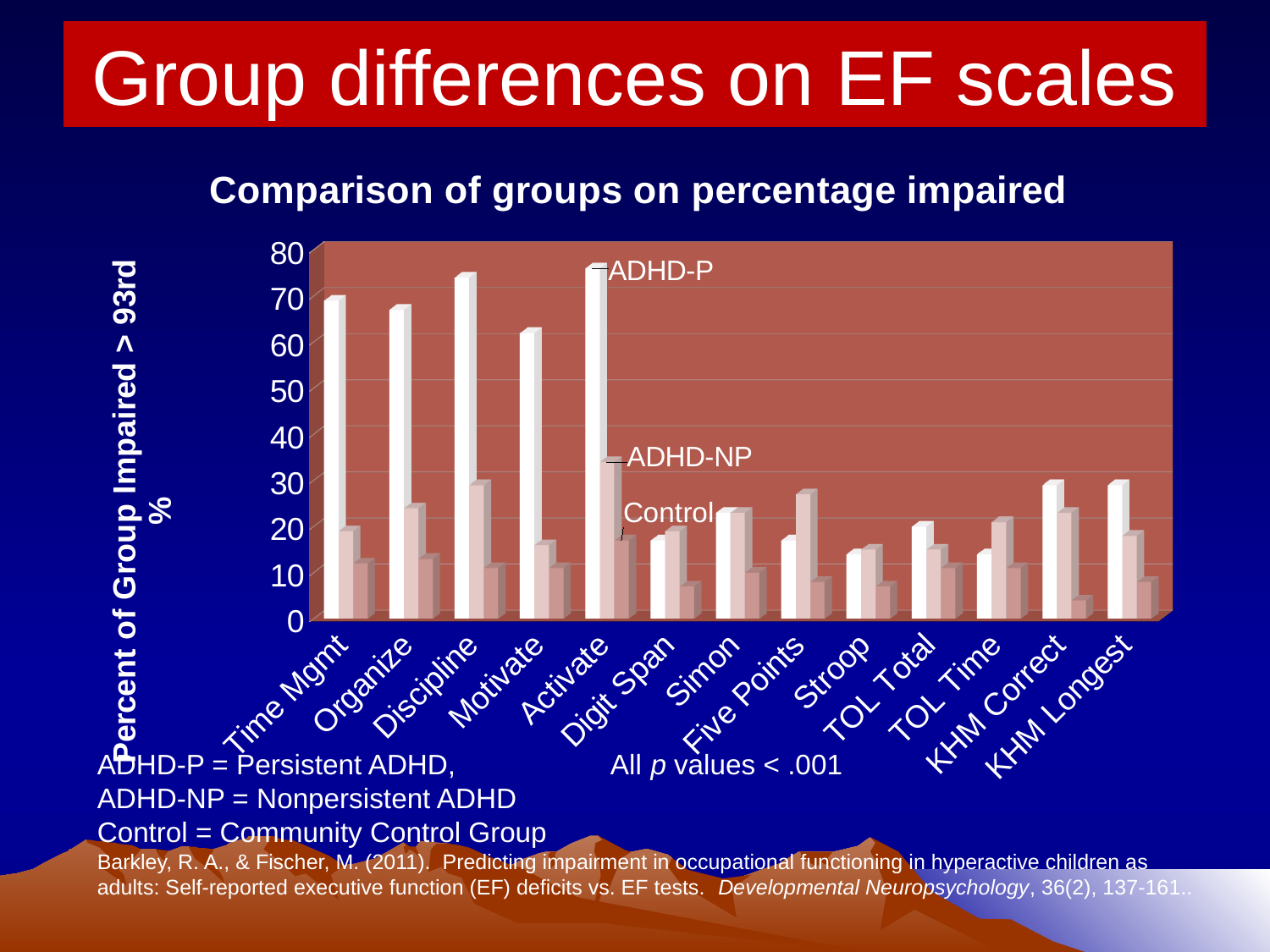
What is the title of the chart? Comparison of groups on percentage impaired How many categories are shown along the x axis of the chart? 13 Is the Control value for Time Mgmt greater or less than 20? less How many groups (series) are plotted in the chart? 3 For the Discipline category, which group has the larger value, ADHD-P or Control? ADHD-P For the ADHD-P group, which category has the larger value, Time Mgmt or Stroop? Time Mgmt What is the label of the vertical axis? Percent of Group Impaired > 93rd % Is the ADHD-P value for Motivate greater or less than 50? greater Is the ADHD-P value for Digit Span greater or less than 30? less What type of chart is shown on the slide? bar chart